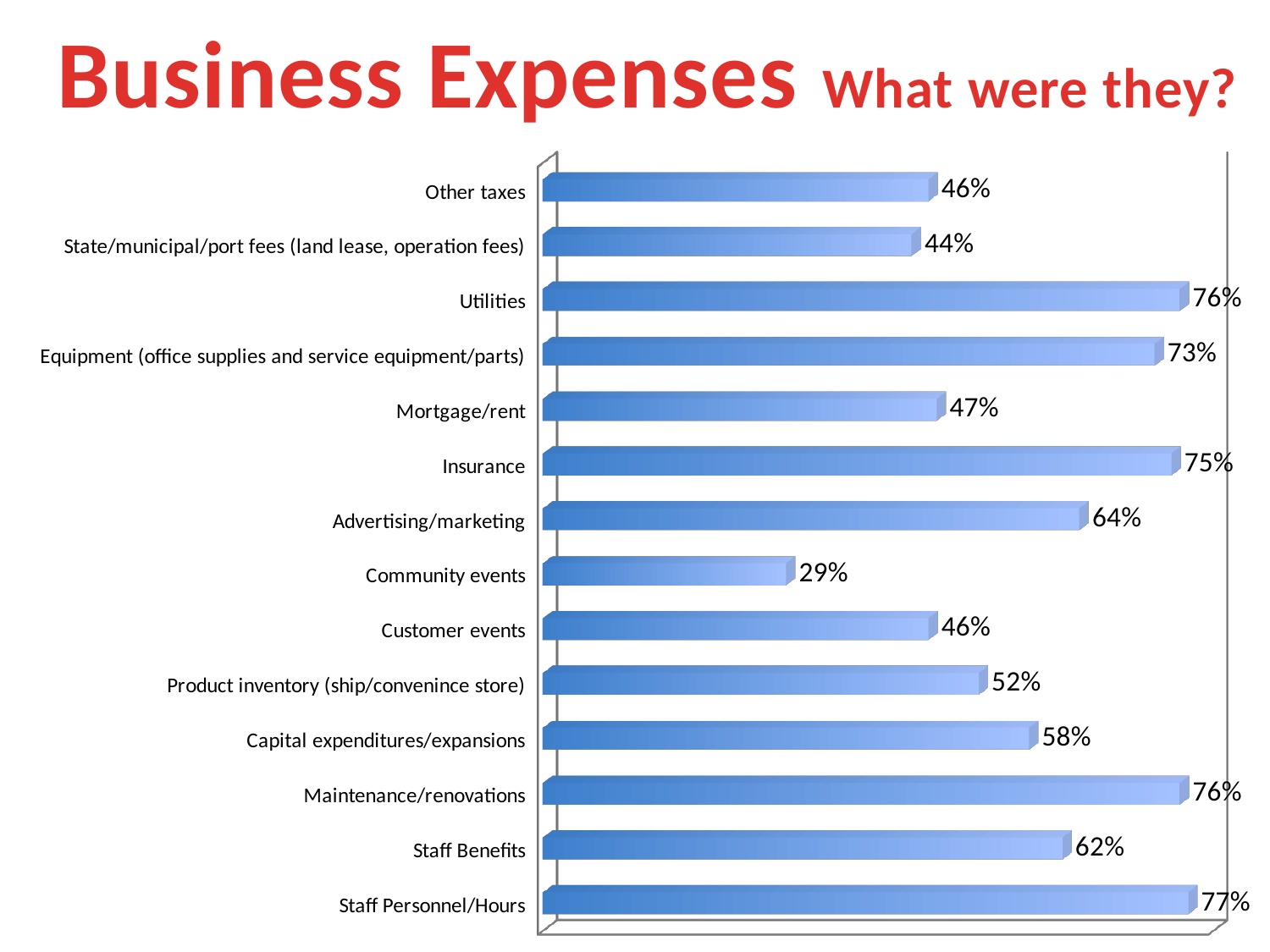
What is the title of the slide containing the chart? Business Expenses What were they? What is the difference between the values for Insurance and Capital expenditures/expansions? 17% What is the value for Mortgage/rent? 47% Which category has the lowest value? Community events What kind of chart is shown on the slide? bar chart What is the difference between the values for Staff Personnel/Hours and Community events? 48% Which category has the highest value? Staff Personnel/Hours What is the value for Advertising/marketing? 64% What is the value for Utilities? 76% What is the value for Staff Benefits? 62% How many categories are plotted in the chart? 14 Which is larger, the value for Equipment (office supplies and service equipment/parts) or the value for Product inventory (ship/convenince store)? Equipment (office supplies and service equipment/parts)